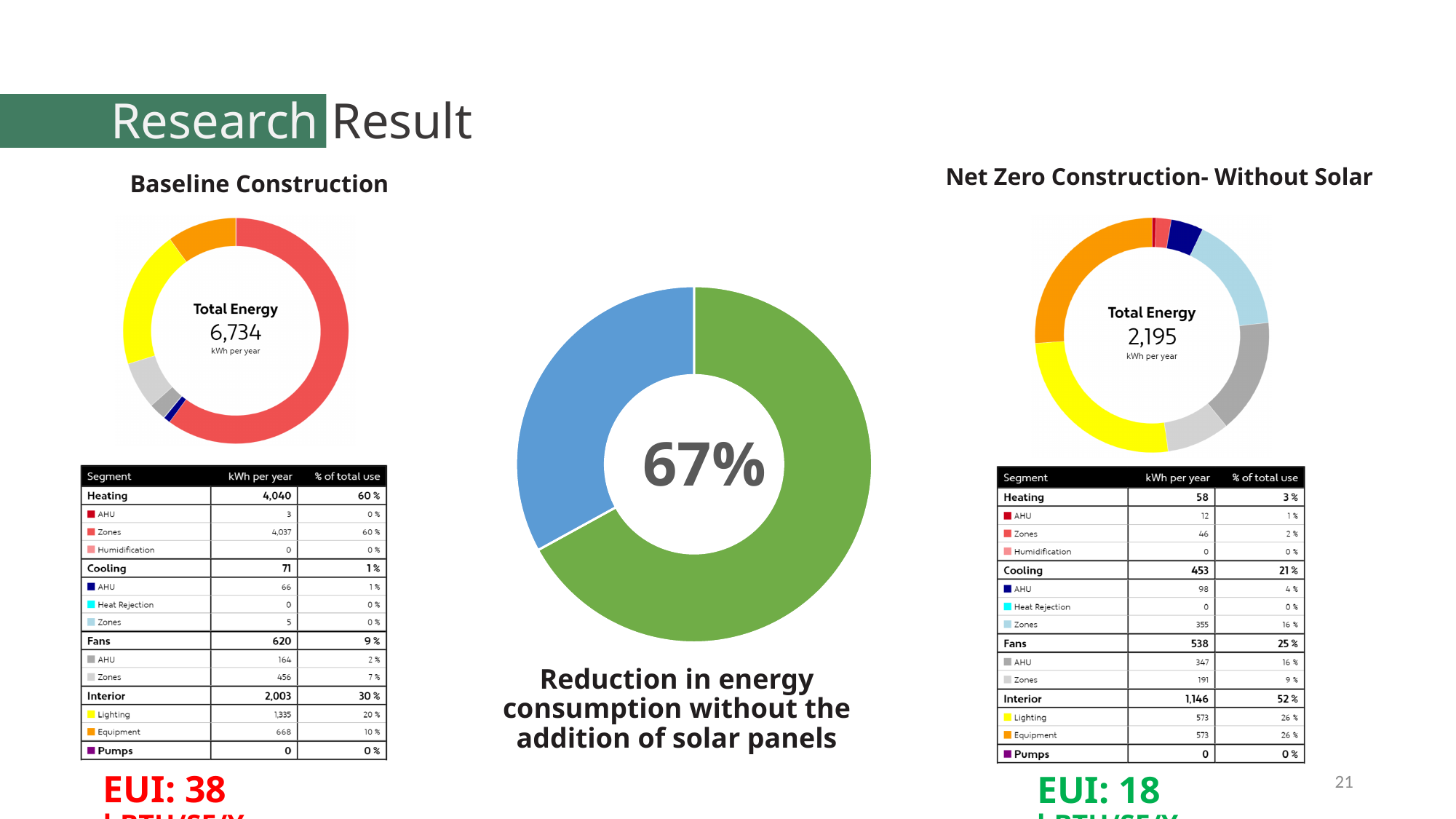
In the Net Zero Construction- Without Solar chart, what share of total use is Fans? 25 % What type of chart is used for the Baseline Construction energy breakdown? Donut (pie) chart In the Baseline Construction chart, what share of total use is Interior? 30 % In the Baseline Construction chart, what is the Total Energy shown in the centre of the donut? 6,734 kWh per year What is the difference in Total Energy between the Baseline Construction chart and the Net Zero Construction- Without Solar chart? 4,539 kWh per year In the Net Zero Construction- Without Solar chart, how many kWh per year does Cooling use? 453 In the Net Zero Construction- Without Solar chart, which uses more energy, Fans or Cooling? Fans In the Net Zero Construction- Without Solar chart, which segment uses the most energy? Interior In the Net Zero Construction- Without Solar chart, what is the Total Energy shown in the centre of the donut? 2,195 kWh per year In the Baseline Construction chart, which segment uses the most energy? Heating What percentage is shown in the centre of the middle donut chart? 67% In the Baseline Construction chart, how many kWh per year does Lighting use? 1,335